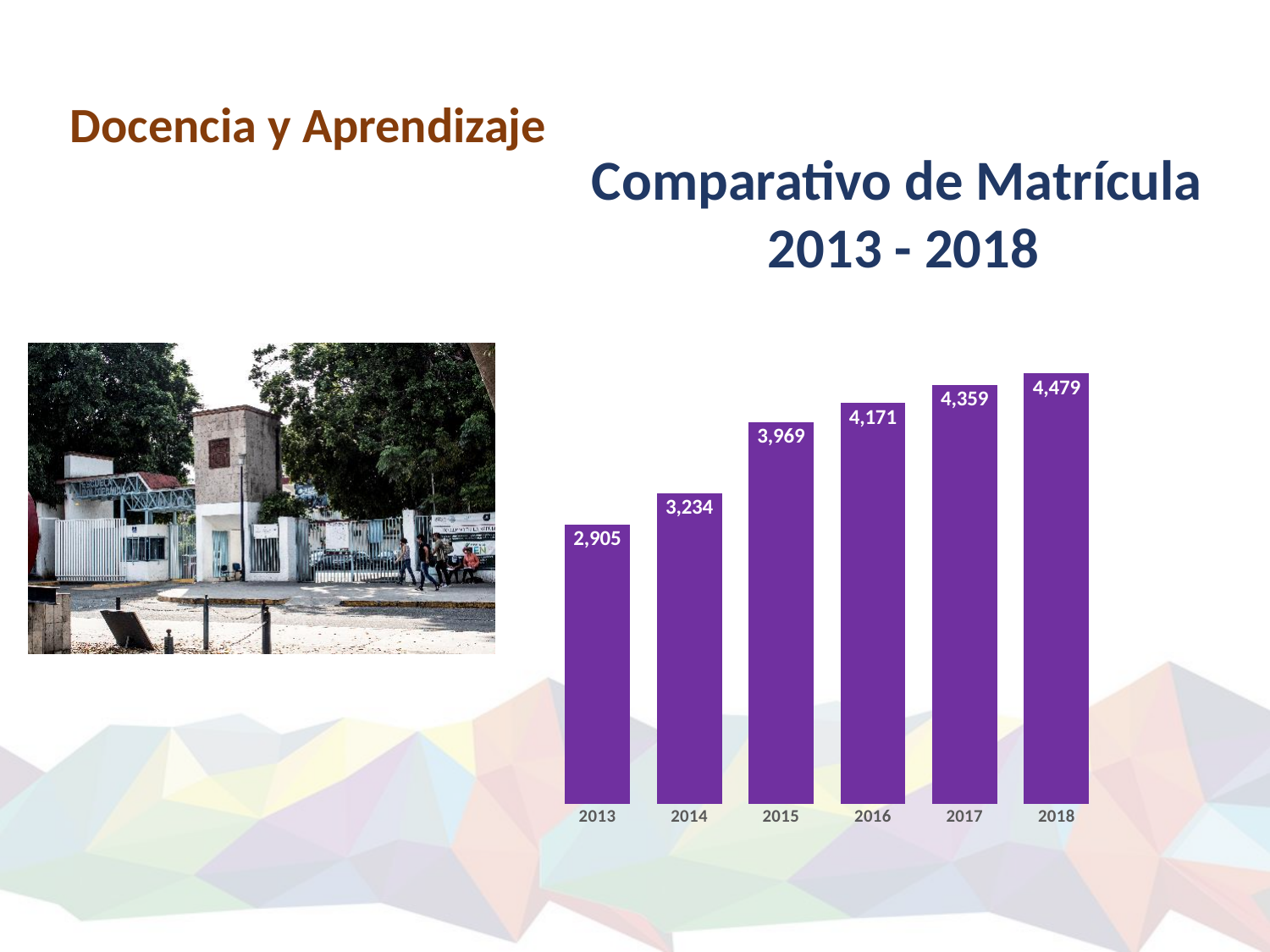
What is the value for 2016? 4,171 What is the difference between the values for 2018 and 2013? 1,574 Do the values rise or fall from 2013 to 2018? rise How many years are shown on the chart? 6 What is the title of the chart? Comparativo de Matrícula 2013 - 2018 Which year has the lowest value? 2013 What is the value for 2018? 4,479 What kind of chart is shown on the slide? bar chart Which is larger, the value for 2014 or the value for 2015? 2015 Which year has the highest value? 2018 What is the difference between the values for 2015 and 2014? 735 What is the value for 2013? 2,905